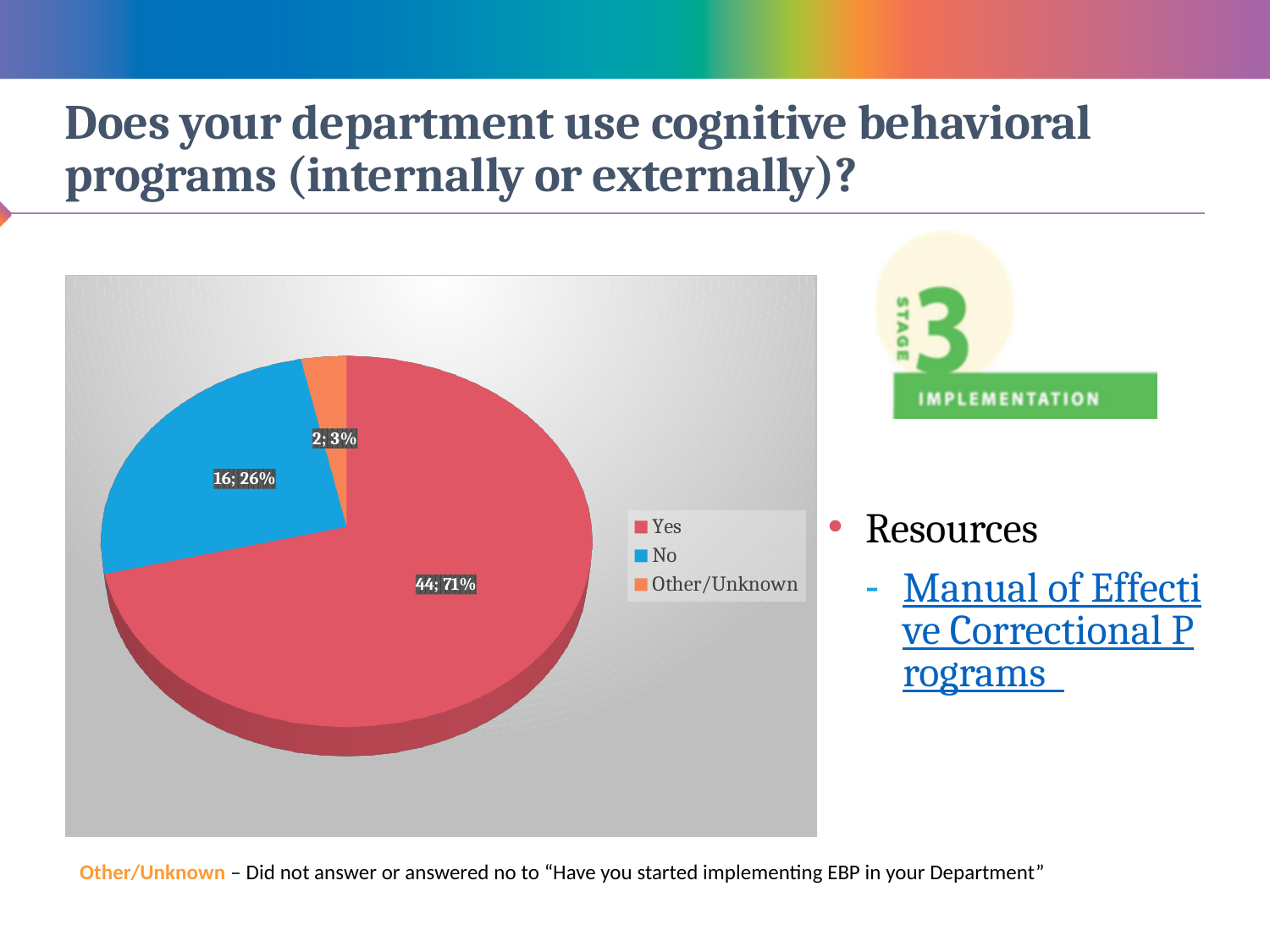
What is the count for the Other/Unknown slice? 2 How many slices does the pie chart have? 3 What is the count for the No slice? 16 How many entries does the legend list? 3 What kind of chart is shown on the slide? Pie chart What is the difference between the Yes count and the No count? 28 What is the count for the Yes slice? 44 What share of the pie does the Yes slice represent? 71% Which category has the smallest slice? Other/Unknown Which category has the largest slice? Yes What share of the pie does the No slice represent? 26% Which colour represents the No slice in the pie chart? Blue